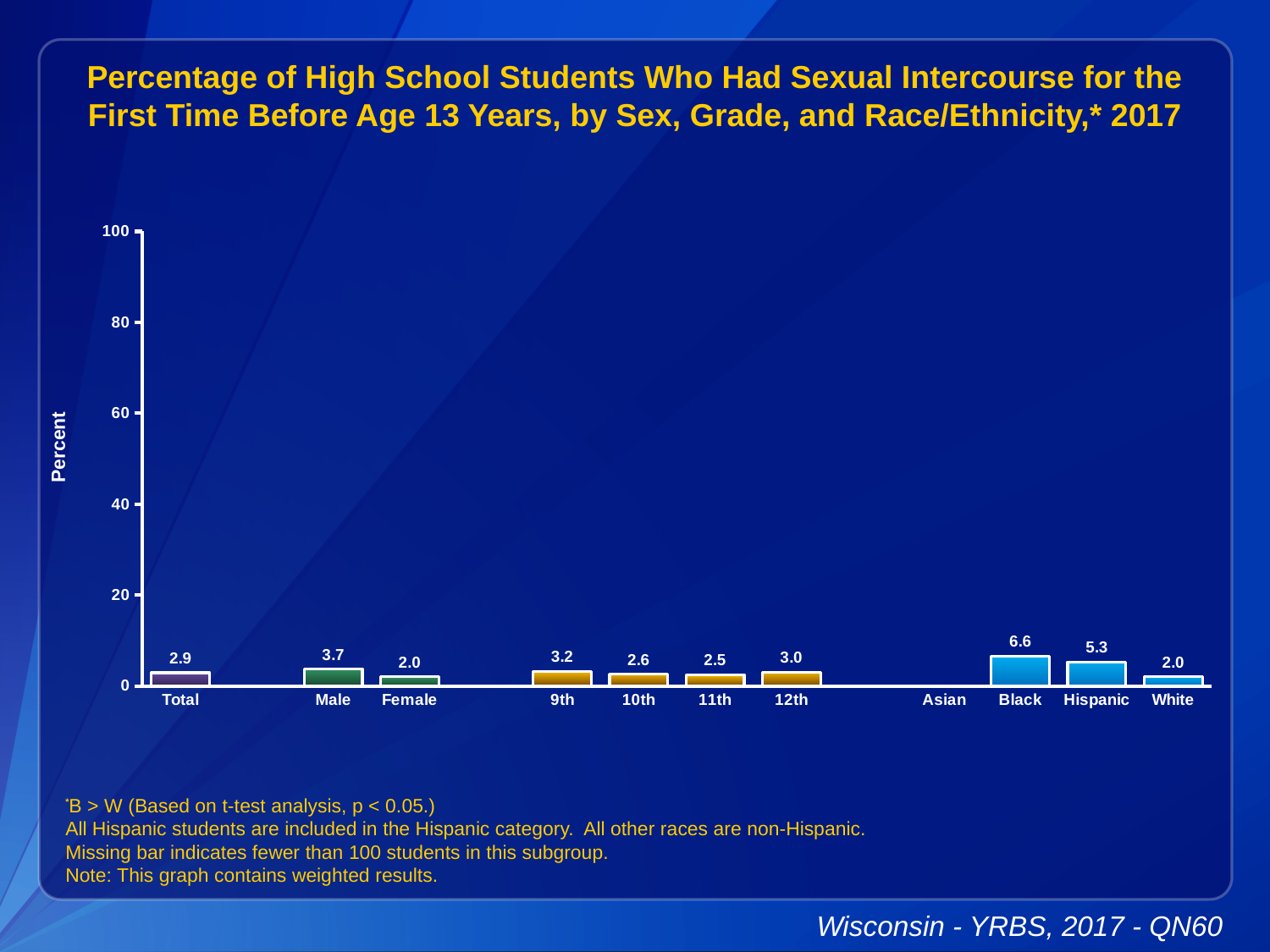
Which category has the highest value? Black How many bars are plotted on the chart? 10 What is the value for Total? 2.9 What is the value for Male? 3.7 What kind of chart is shown? Bar chart What is the value for Black? 6.6 What is the difference between the values for Male and Female? 1.7 What is the difference between the values for Black and White? 4.6 Which category on the x axis has no bar plotted? Asian Which is larger, the value for 9th grade or 12th grade? 9th What is the value for 11th grade? 2.5 Which is larger, the value for Hispanic or White? Hispanic